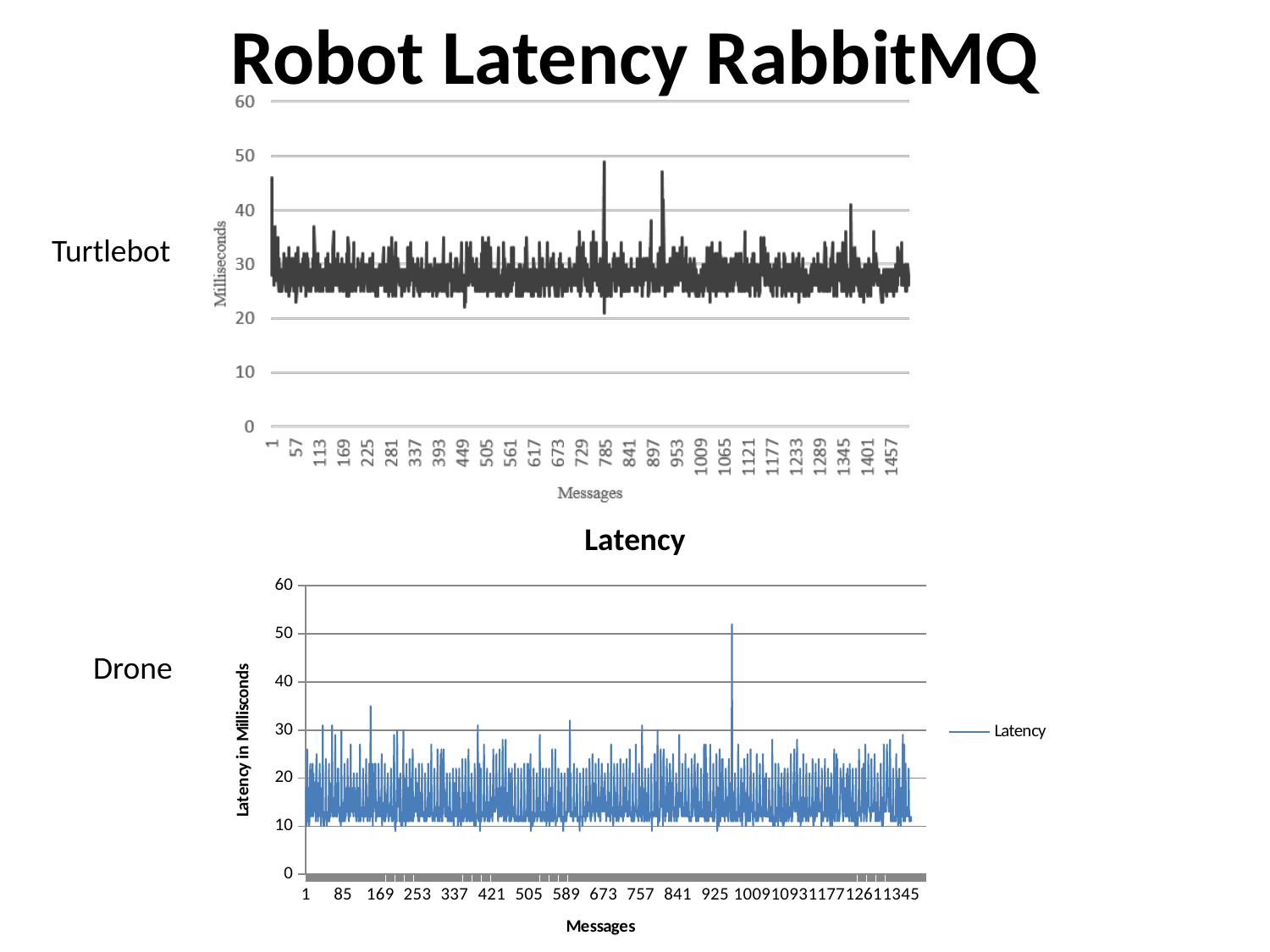
What kind of chart is the Turtlebot chart at the top of the slide? line chart What kind of chart is the Drone chart titled "Latency" at the bottom of the slide? line chart In the Turtlebot chart at the top of the slide, do the latency values show a clear rising trend, a clear falling trend, or stay roughly flat across the messages? roughly flat In the Turtlebot chart at the top of the slide, are most of the plotted latency values greater or less than 20? greater In the Drone chart titled "Latency", do the latency values show a clear rising trend, a clear falling trend, or stay roughly flat across the messages? roughly flat In the Drone chart titled "Latency", are most of the plotted latency values greater or less than 30? less In the Drone chart titled "Latency", is the highest spike in latency greater or less than 40? greater In the Drone chart titled "Latency", how many series does the legend list? 1 Comparing the two charts, which robot shows the higher typical latency, the Turtlebot or the Drone? Turtlebot In the Turtlebot chart at the top of the slide, what is the label of the x axis? Messages In the Drone chart titled "Latency", what is the name of the series shown in the legend? Latency